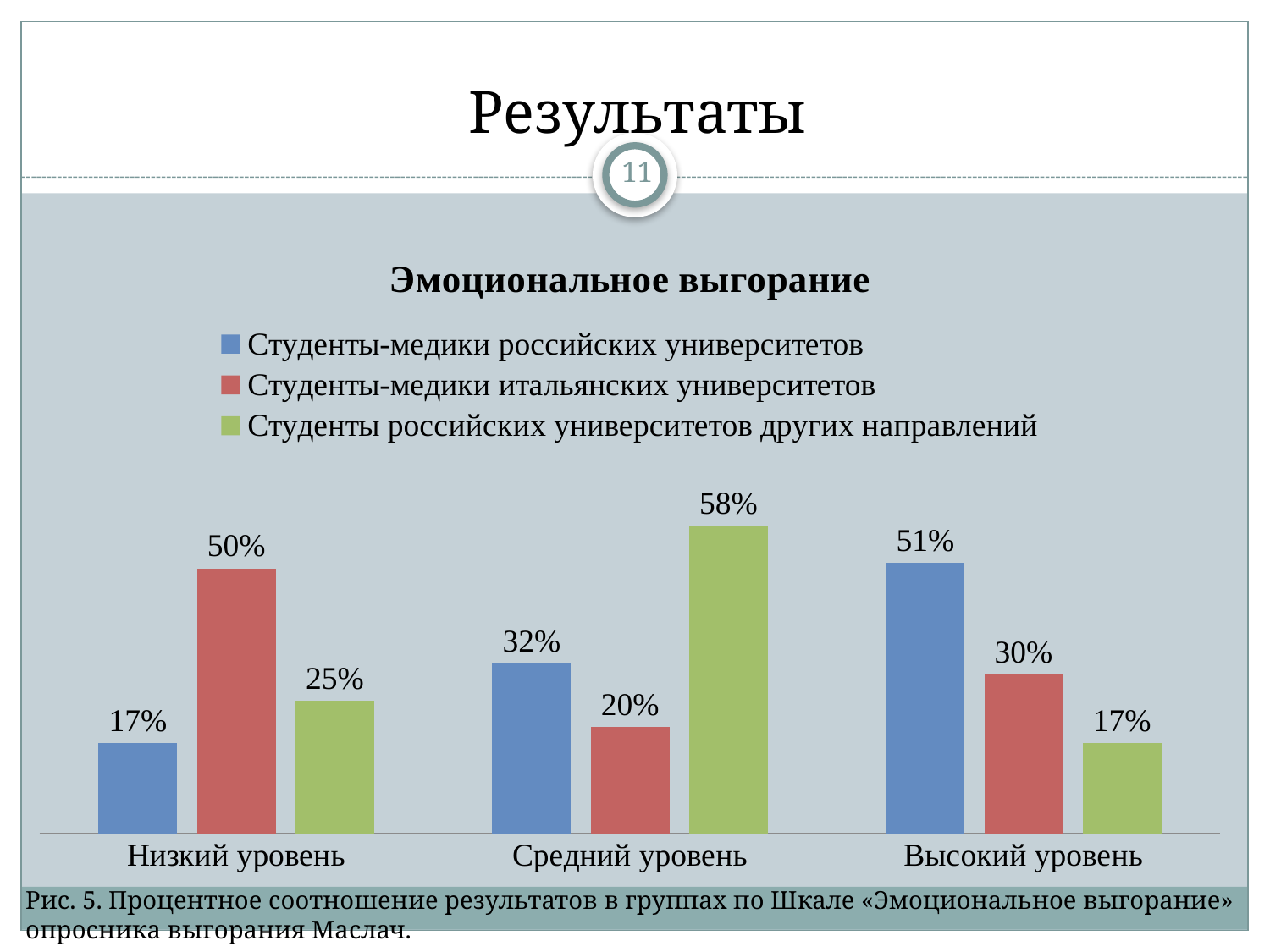
What is the value for Студенты российских университетов других направлений at Средний уровень? 58% What is the title of the chart? Эмоциональное выгорание At Высокий уровень, which is larger: the value for Студенты-медики российских университетов or for Студенты российских университетов других направлений? Студенты-медики российских университетов What kind of chart is shown on the slide? Bar chart Which category has the lowest value for Студенты-медики итальянских университетов? Средний уровень What is the value for Студенты-медики российских университетов at Низкий уровень? 17% How many series does the legend list? 3 What is the value for Студенты-медики итальянских университетов at Высокий уровень? 30% What is the difference between the values for Студенты-медики итальянских университетов and Студенты-медики российских университетов at Низкий уровень? 33% What is the value for Студенты-медики итальянских университетов at Низкий уровень? 50% How many categories are shown on the x axis? 3 Which category has the highest value for Студенты-медики российских университетов? Высокий уровень